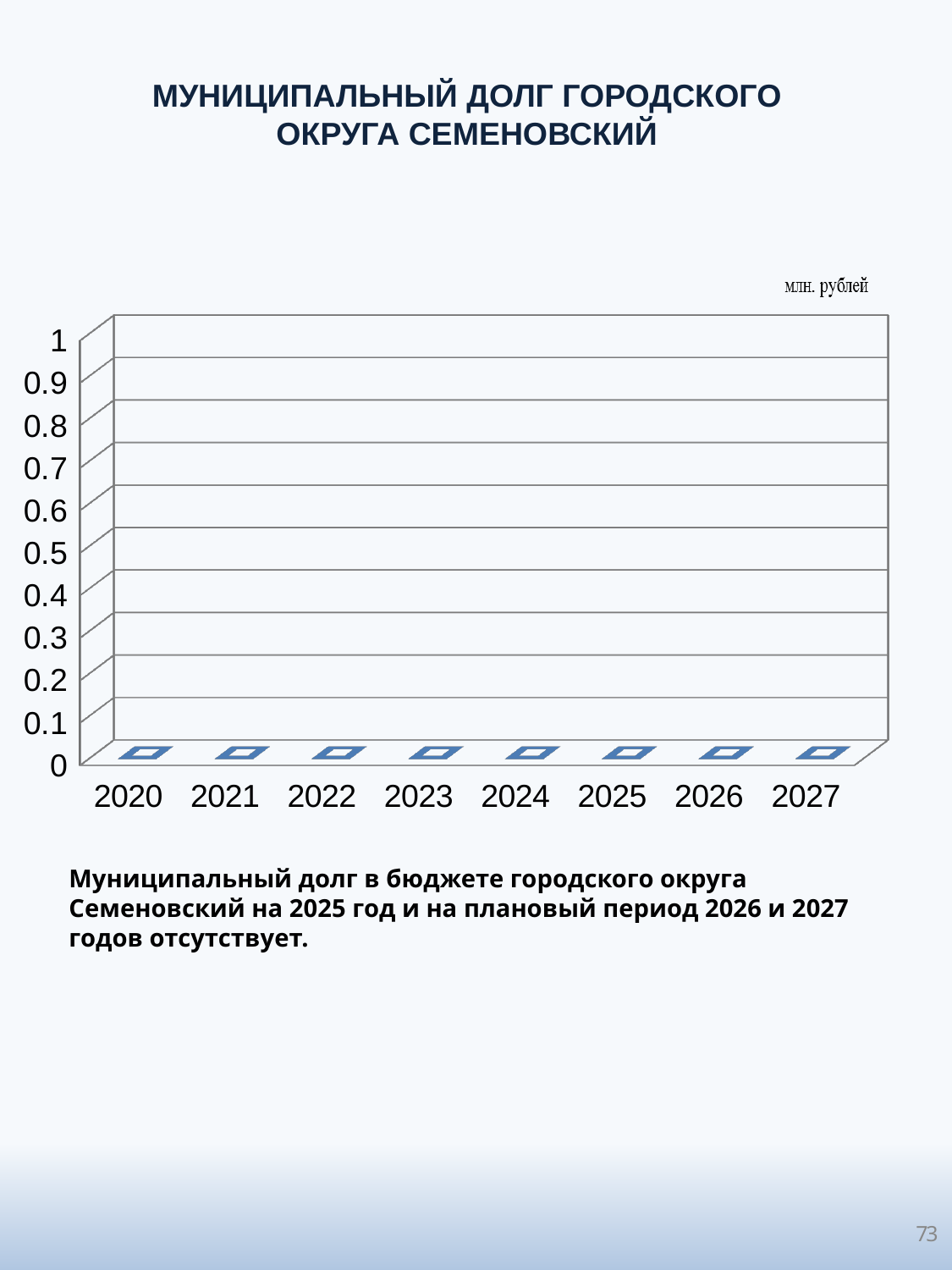
What is the difference between the values for 2024 and 2021? 0 What is the value of municipal debt for 2020? 0 What is the highest value shown on the y axis? 1 What kind of chart is shown on the slide? bar chart What is the last year shown on the x axis? 2027 How many years are shown on the x axis of the chart? 8 Is the value for 2026 greater or less than 0.1? less What is the value of municipal debt for 2027? 0 What is the value of municipal debt for 2025? 0 What is the first year shown on the x axis? 2020 Is the value for 2023 greater or less than 0.5? less Do the values rise, fall or stay the same from 2020 to 2027? stay the same